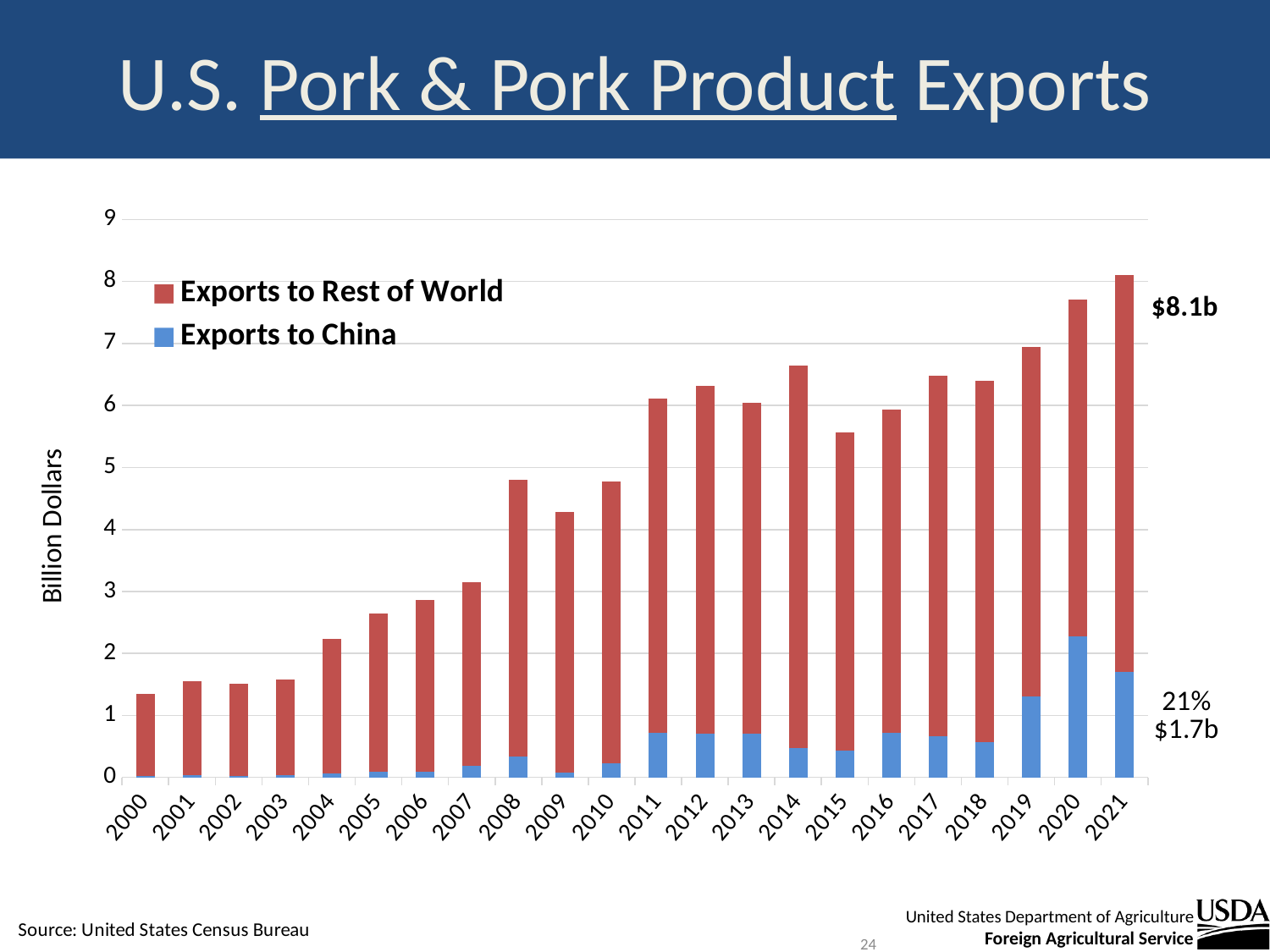
Is the value of exports to China in 2020 greater or less than 2 billion dollars? greater Which year has the lowest total exports? 2000 How many years are shown on the x axis of the chart? 22 What is the total value of U.S. pork and pork product exports in 2021, as labeled on the chart? $8.1b Which year has larger total exports, 2014 or 2015? 2014 Is the total export value for 2000 greater or less than 2 billion dollars? less What is the label on the y axis of the chart? Billion Dollars What kind of chart is shown on the slide? Stacked bar chart What is the value of exports to China in 2021, as labeled on the chart? $1.7b What percentage share of 2021 exports went to China, according to the label on the chart? 21% How many series does the legend list? 2 Which year has the highest total exports? 2021